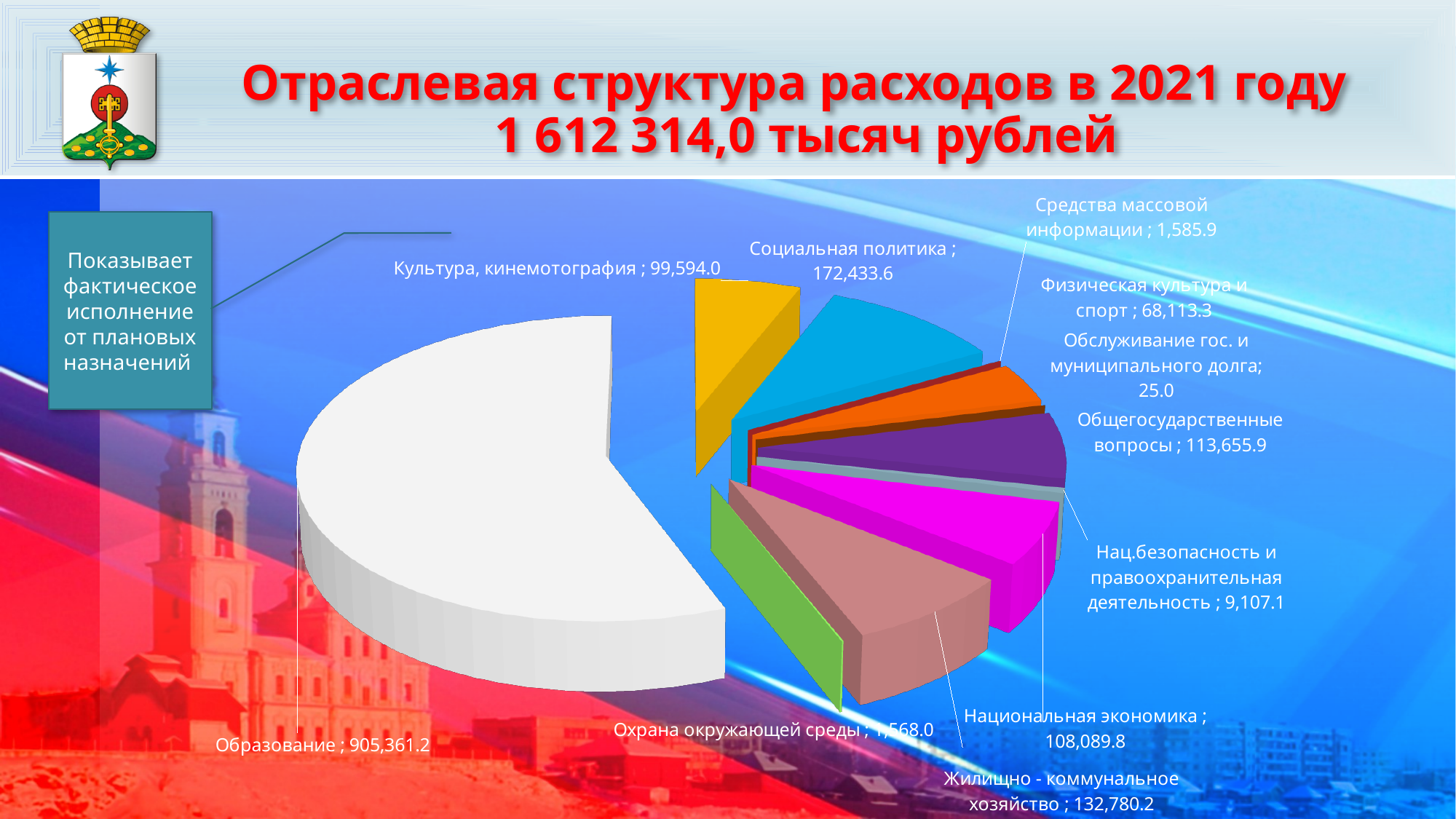
What is the title of the chart on the slide? Отраслевая структура расходов в 2021 году 1 612 314,0 тысяч рублей Which category has the smallest value in the pie chart? Обслуживание гос. и муниципального долга What is the difference between Общегосударственные вопросы and Национальная экономика? 5,566.1 Which is larger: Культура, кинемотография or Физическая культура и спорт? Культура, кинемотография What is the value for Образование? 905,361.2 What is the value for Средства массовой информации? 1,585.9 What is the difference between Социальная политика and Жилищно - коммунальное хозяйство? 39,653.4 Which category has the largest value in the pie chart? Образование What is the value for Социальная политика? 172,433.6 How many categories (slices) does the pie chart show? 11 What kind of chart is shown on the slide? Pie chart What is the value for Жилищно - коммунальное хозяйство? 132,780.2